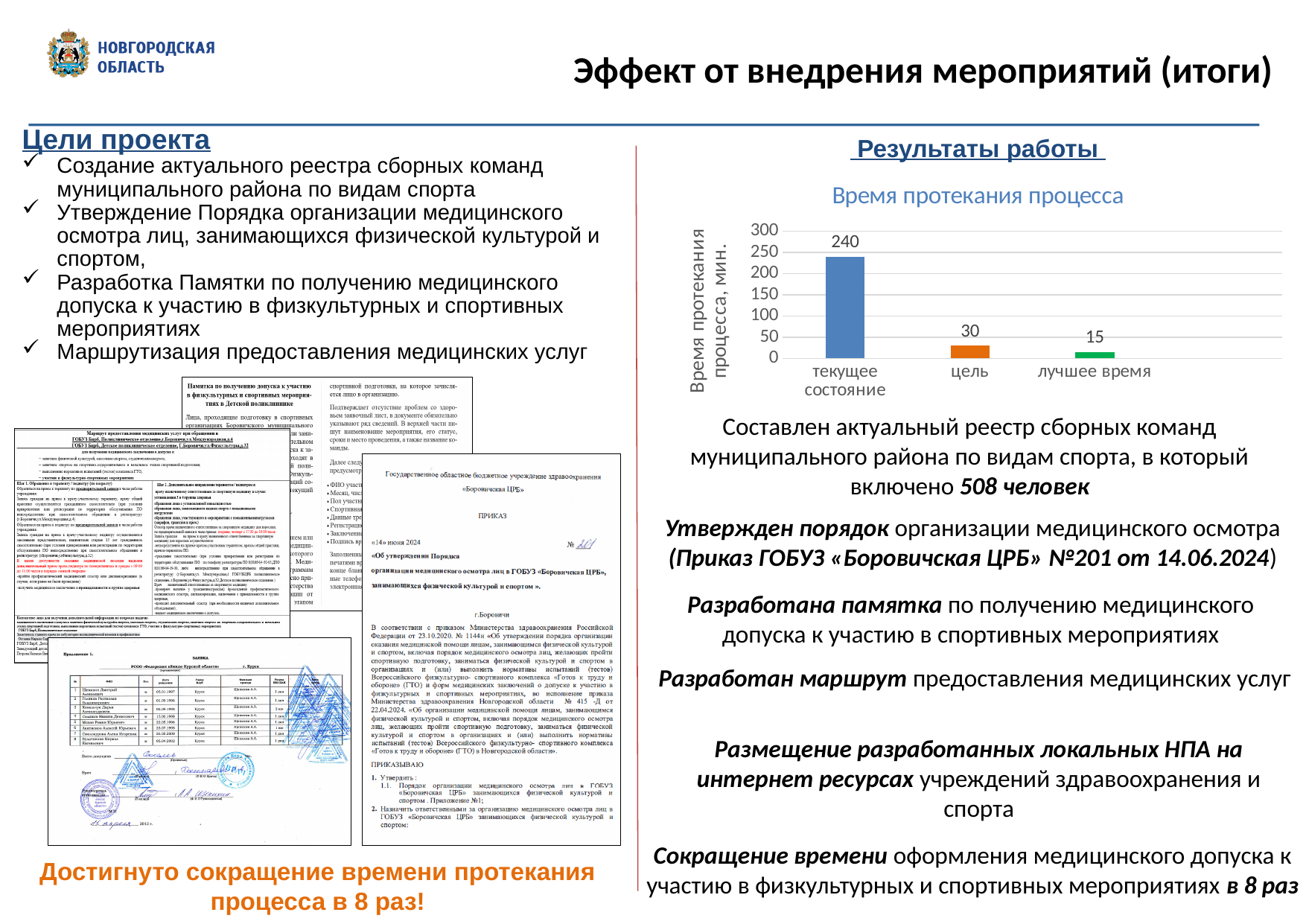
Is the value for "текущее состояние" in the chart "Время протекания процесса" greater or less than 200? greater What is the value for "цель" in the chart "Время протекания процесса"? 30 How many categories are shown in the chart "Время протекания процесса"? 3 What is the value for "текущее состояние" in the chart "Время протекания процесса"? 240 What is the difference between the values for "цель" and "лучшее время" in the chart "Время протекания процесса"? 15 Which is larger in the chart "Время протекания процесса": the value for "цель" or the value for "лучшее время"? цель What kind of chart is "Время протекания процесса"? bar chart What is the value for "лучшее время" in the chart "Время протекания процесса"? 15 What is the difference between the values for "текущее состояние" and "цель" in the chart "Время протекания процесса"? 210 What is the label of the vertical axis in the chart "Время протекания процесса"? Время протекания процесса, мин. Which category has the highest value in the chart "Время протекания процесса"? текущее состояние Which category has the lowest value in the chart "Время протекания процесса"? лучшее время